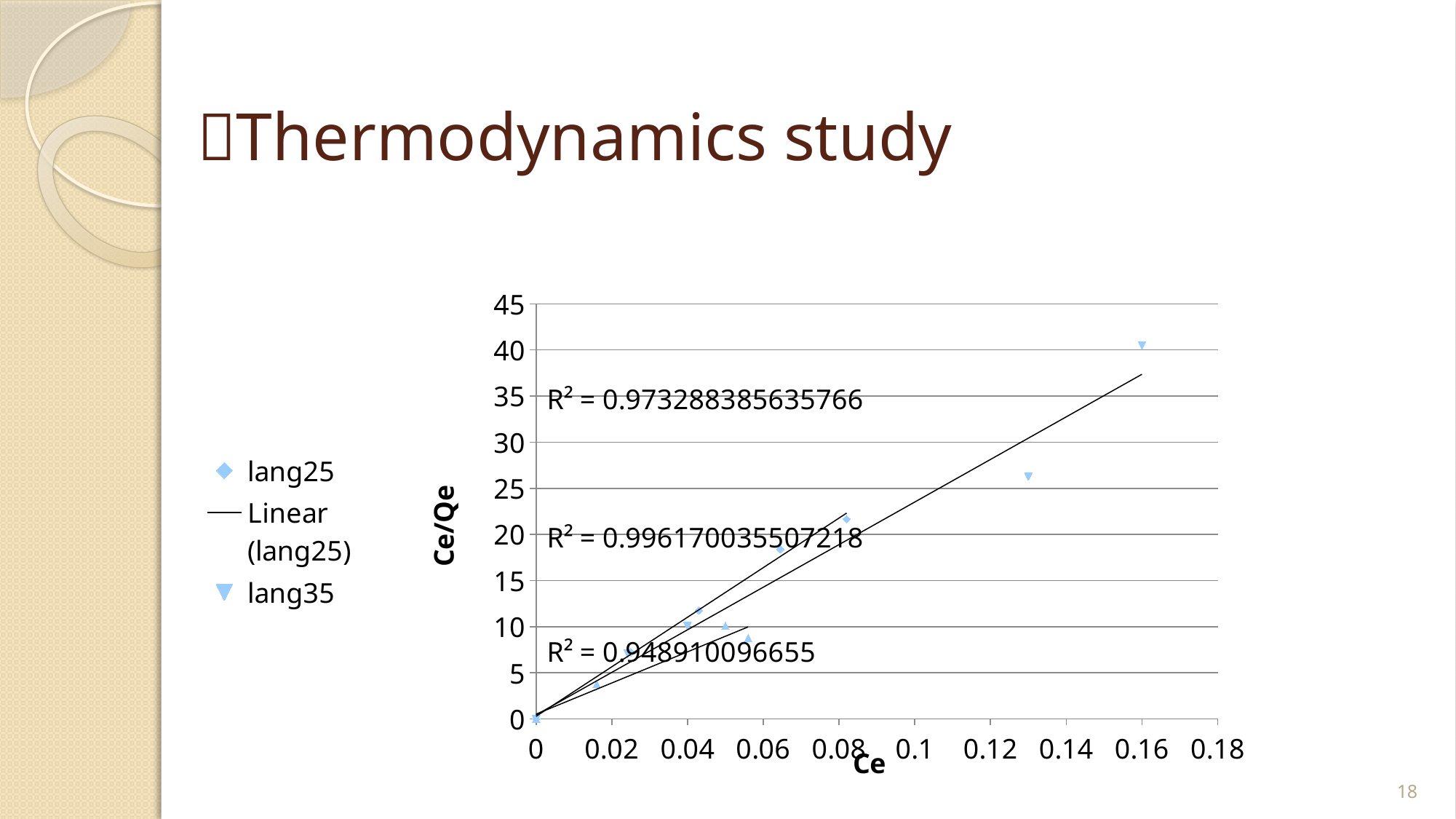
What is the lowest R² value printed on the chart? 0.948910096655 What is the title of the horizontal axis of the chart? Ce What is the title of the vertical axis of the chart? Ce/Qe What kind of chart is shown on the slide? scatter chart What R² value is printed near the 35 gridline on the chart? 0.973288385635766 Which series reaches the highest Ce/Qe value on the chart, lang25 or lang35? lang35 What is the maximum value shown on the vertical axis of the chart? 45 How many entries does the chart legend list? 3 What is the highest R² value printed on the chart? 0.996170035507218 Is the Ce/Qe value of the lang35 point at Ce = 0.16 greater or less than 35? greater Is the Ce/Qe value of the lang35 point at Ce = 0.13 greater or less than 20? greater Do the Ce/Qe values generally rise or fall as Ce increases along the x axis? rise